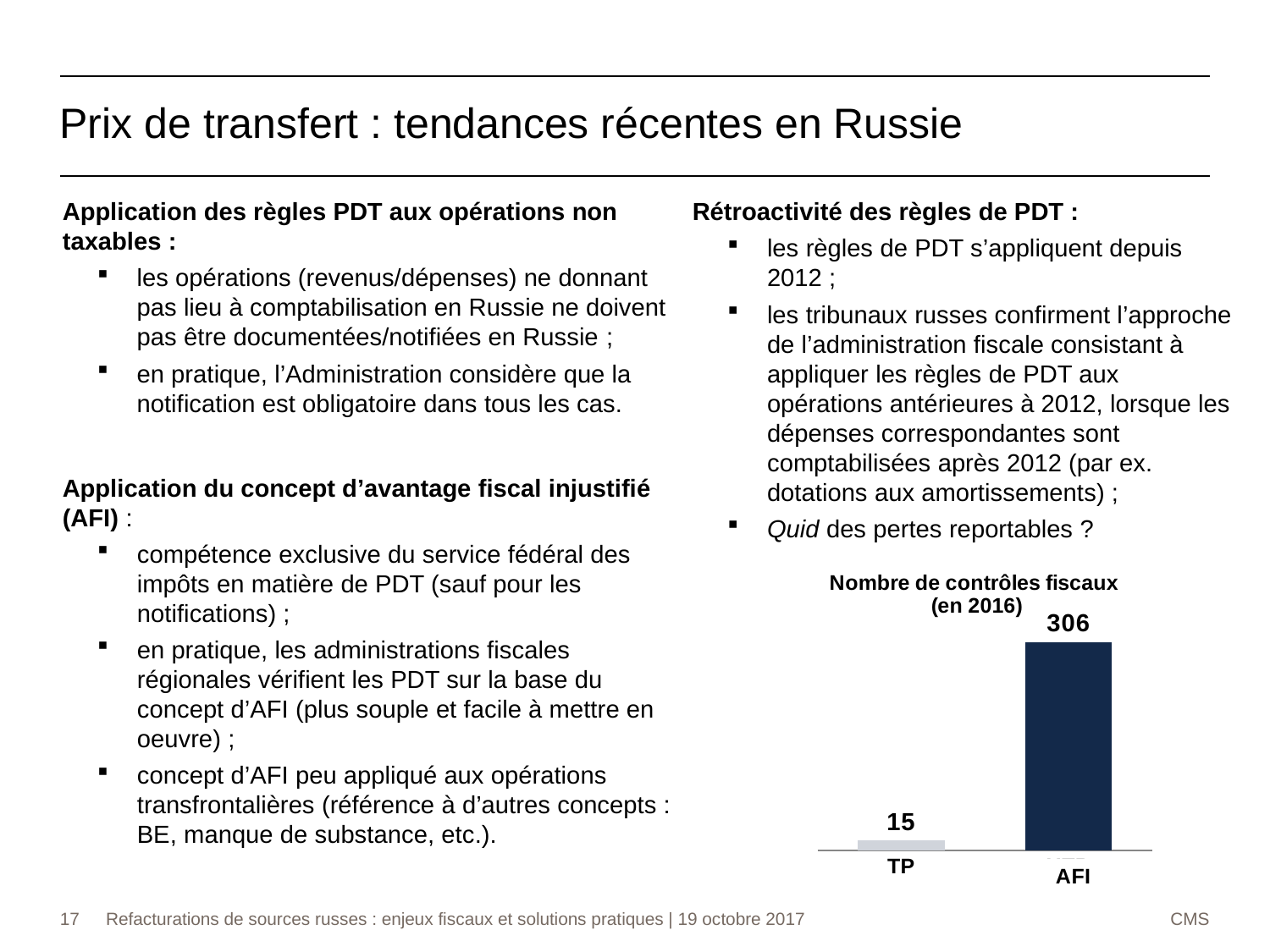
What is the value for TP in the chart 'Nombre de contrôles fiscaux (en 2016)'? 15 In the chart 'Nombre de contrôles fiscaux (en 2016)', which is larger, the value for TP or the value for AFI? AFI What is the value for AFI in the chart 'Nombre de contrôles fiscaux (en 2016)'? 306 What kind of chart is 'Nombre de contrôles fiscaux (en 2016)'? Bar chart What is the difference between the AFI and TP values in the chart 'Nombre de contrôles fiscaux (en 2016)'? 291 What is the total of the two values shown in the chart 'Nombre de contrôles fiscaux (en 2016)'? 321 What is the title of the chart on the slide? Nombre de contrôles fiscaux (en 2016) How many categories are shown in the chart 'Nombre de contrôles fiscaux (en 2016)'? 2 Which category has the highest value in the chart 'Nombre de contrôles fiscaux (en 2016)'? AFI Which category has the lowest value in the chart 'Nombre de contrôles fiscaux (en 2016)'? TP Which year does the chart 'Nombre de contrôles fiscaux' refer to? 2016